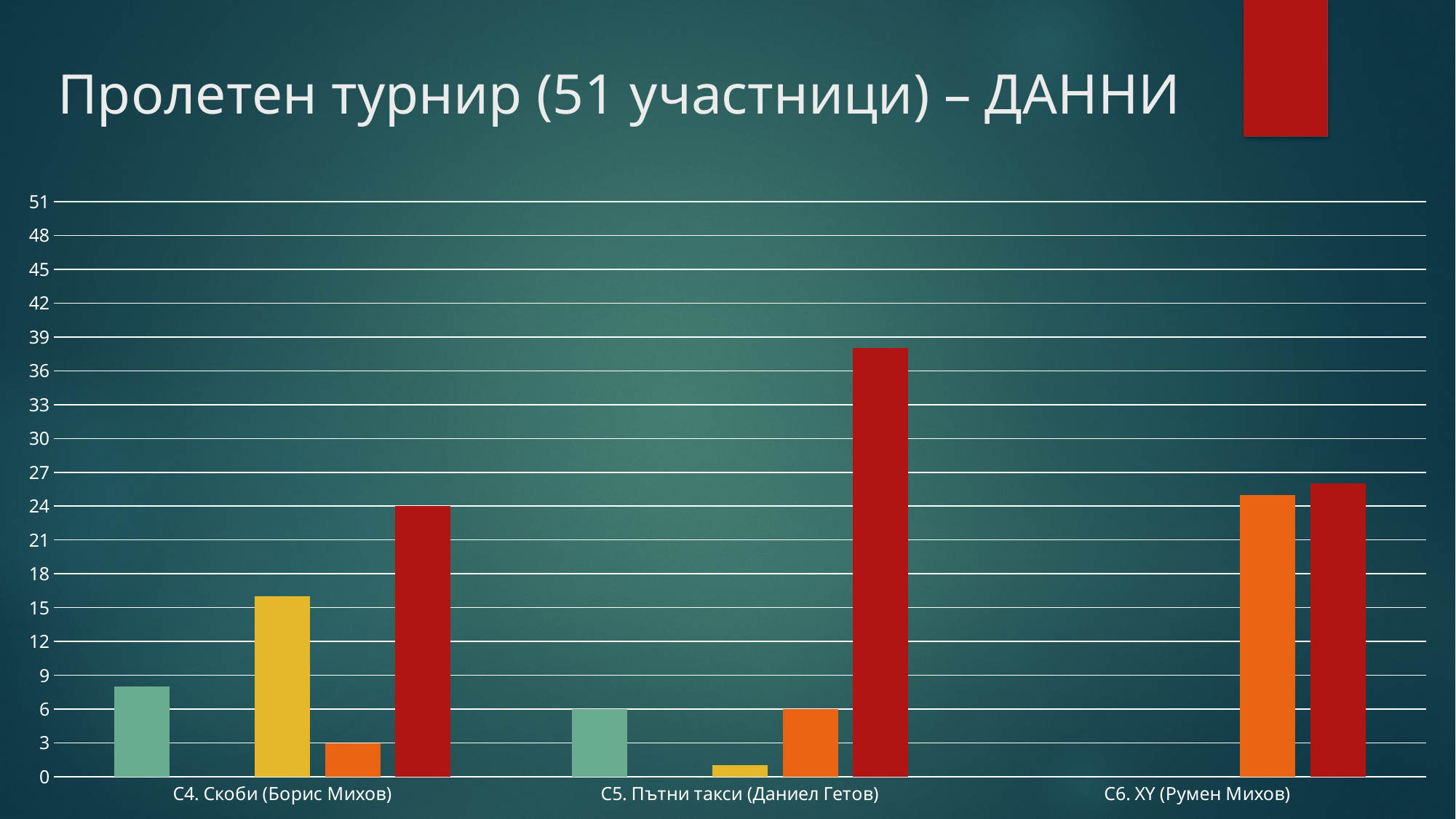
Which is larger: the red bar for C4. Скоби (Борис Михов) or the red bar for C5. Пътни такси (Даниел Гетов)? C5. Пътни такси (Даниел Гетов) What is the title of the slide? Пролетен турнир (51 участници) – ДАННИ What is the value of the red bar for C4. Скоби (Борис Михов)? 24 Is the value of the yellow bar for C4. Скоби (Борис Михов) greater or less than 18? less What is the value of the orange bar for C4. Скоби (Борис Михов)? 3 Which category contains the tallest bar in the chart? C5. Пътни такси (Даниел Гетов) How many categories are shown on the x axis? 3 What is the difference between the red bar and the orange bar for C4. Скоби (Борис Михов)? 21 Is the value of the red bar for C5. Пътни такси (Даниел Гетов) greater or less than 36? greater What is the value of the teal bar for C5. Пътни такси (Даниел Гетов)? 6 Is the value of the orange bar for C6. XY (Румен Михов) greater or less than 21? greater What kind of chart is shown on the slide? bar chart